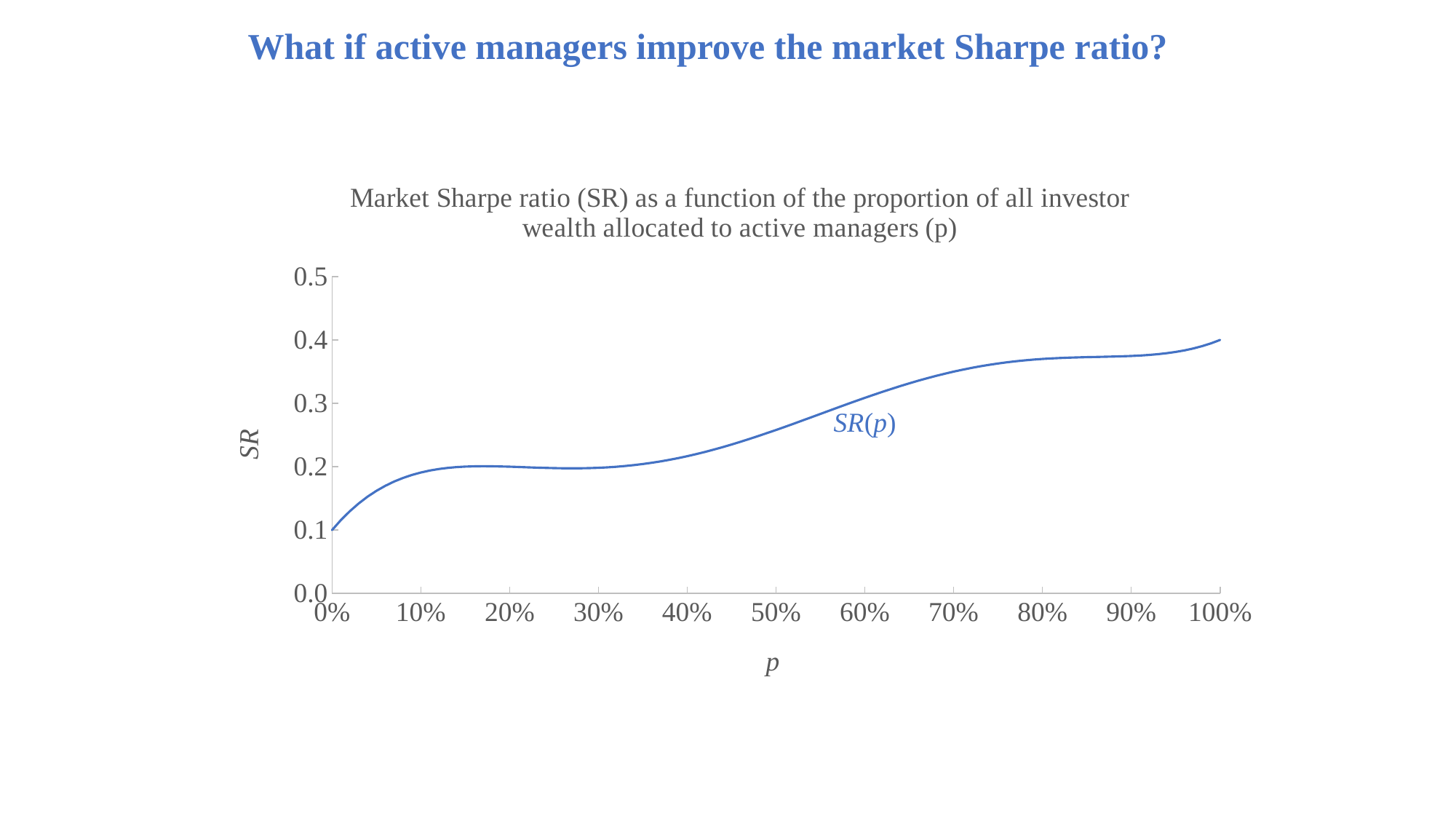
How many series are plotted on the chart? 1 What is the value of SR(p) at p = 100%? 0.4 Is the value of SR(p) at p = 40% greater or less than 0.3? less Is the value of SR(p) at p = 50% greater or less than 0.3? less At which value of p is SR(p) highest? 100% Is the value of SR(p) at p = 80% greater or less than 0.3? greater What kind of chart is shown on the slide? line chart What is the title of the chart? Market Sharpe ratio (SR) as a function of the proportion of all investor wealth allocated to active managers (p) At which value of p is SR(p) lowest? 0% What is the value of SR(p) at p = 0%? 0.1 What label is attached to the plotted line? SR(p) Overall, does SR(p) rise or fall as p increases from 0% to 100%? rise